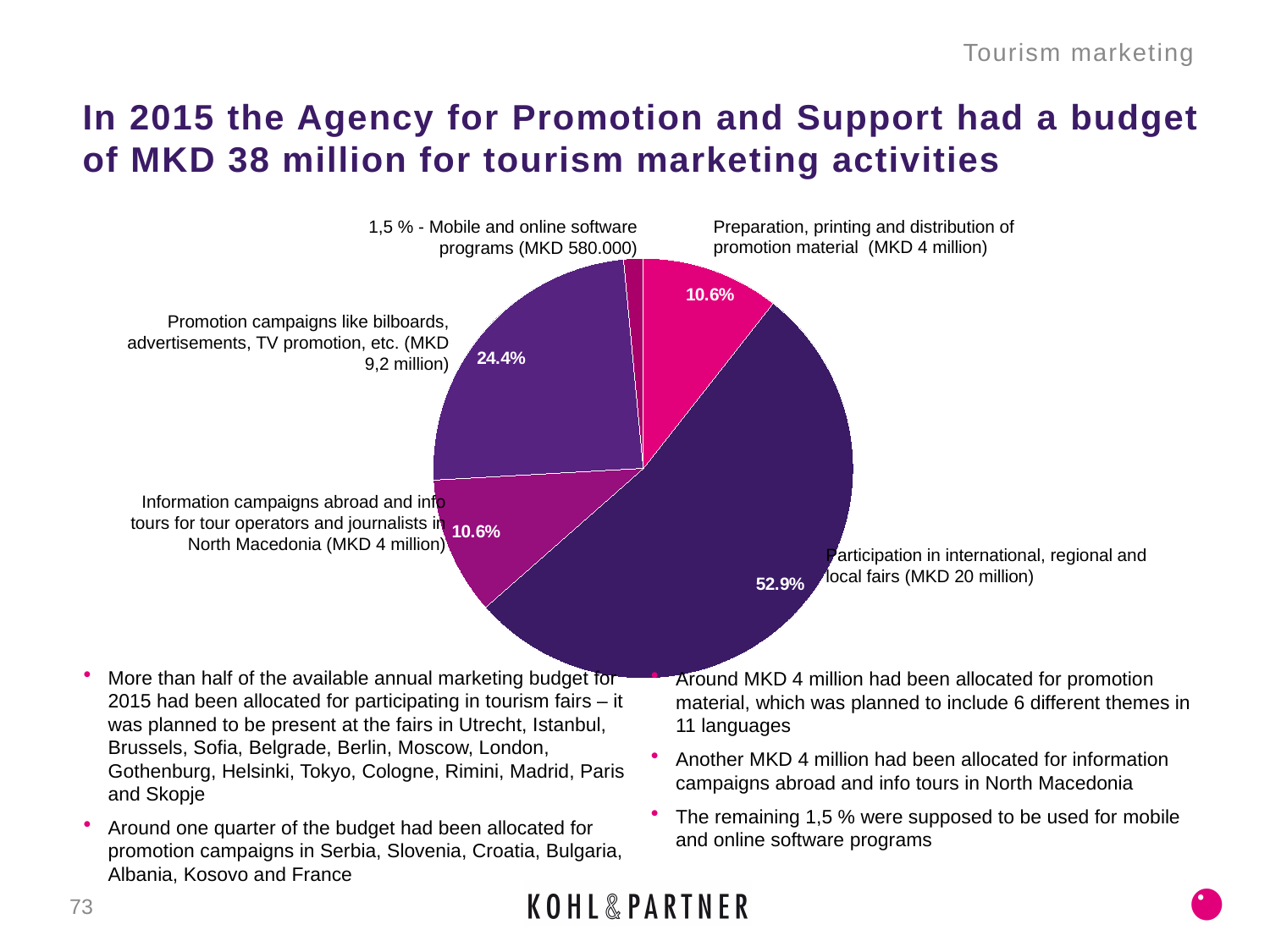
What is the difference in percentage points between the share for participation in fairs and the share for promotion campaigns like billboards? 28.5 What share of the budget went to participation in international, regional and local fairs? 52.9% What amount in MKD was allocated to mobile and online software programs? MKD 580.000 What share of the budget went to preparation, printing and distribution of promotion material? 10.6% What amount in MKD was allocated to promotion campaigns like billboards, advertisements, TV promotion, etc.? MKD 9,2 million Which category received the smallest share of the budget? Mobile and online software programs What share of the budget went to promotion campaigns like billboards, advertisements, TV promotion, etc.? 24.4% How many slices does the pie chart have? 5 Which is larger: the share for promotion campaigns like billboards or the share for information campaigns abroad and info tours? Promotion campaigns like billboards What kind of chart is shown on the slide? pie chart Which category received the largest share of the budget? Participation in international, regional and local fairs